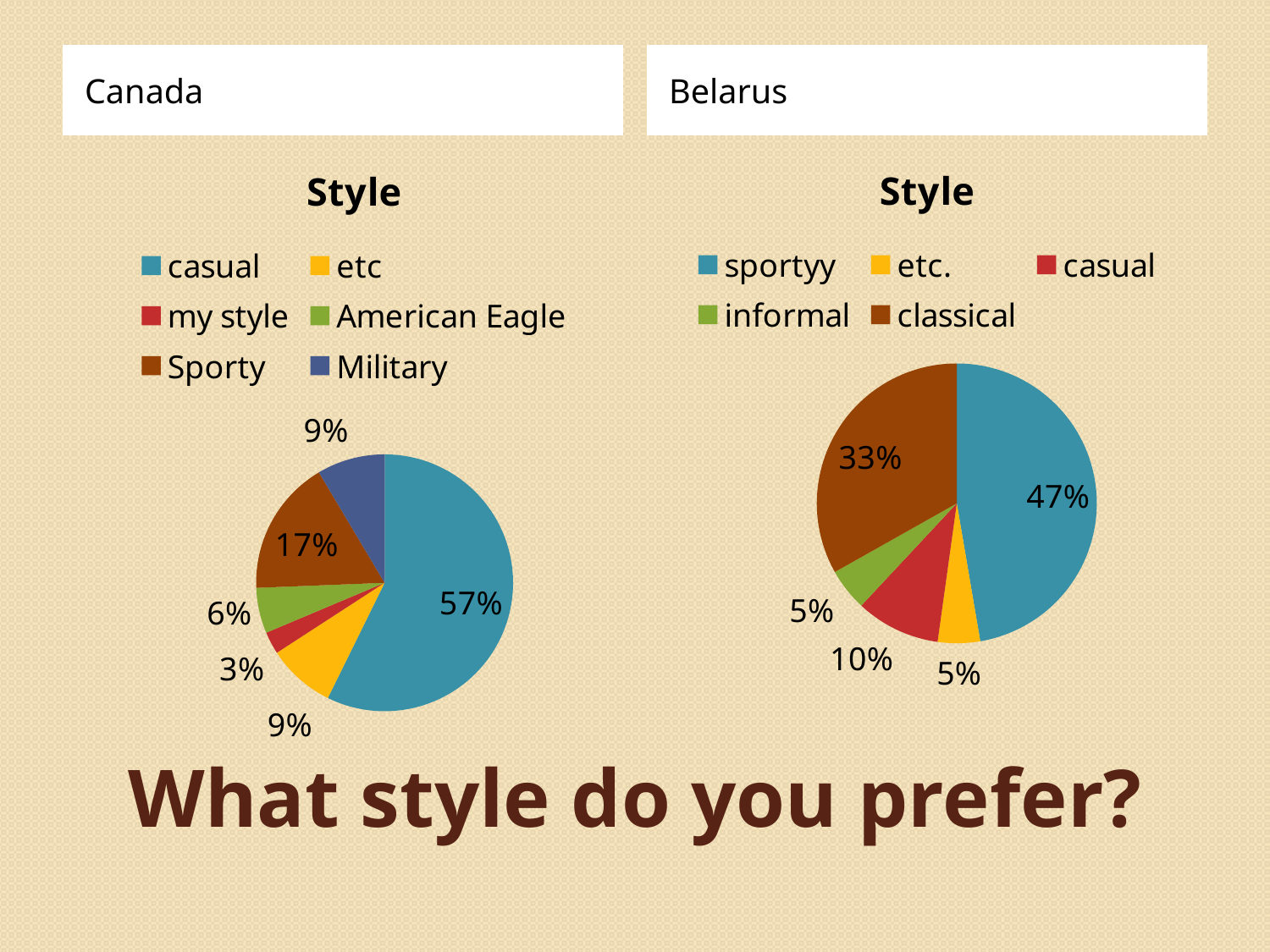
On the right (Belarus) pie chart, what share does classical have? 33% On the left (Canada) pie chart, which category has the largest slice? casual On the right (Belarus) pie chart, what share does sportyy have? 47% On the right (Belarus) pie chart, which is larger, casual or informal? casual On the left (Canada) pie chart, what share does Sporty have? 17% On the left (Canada) pie chart, what share does casual have? 57% What type of chart is used for both Canada and Belarus on this slide? Pie chart On the left (Canada) pie chart, which category has the smallest slice? my style On the left (Canada) pie chart, what share does my style have? 3% On the left (Canada) pie chart, how many categories does the legend list? 6 On the right (Belarus) pie chart, how many categories does the legend list? 5 On the right (Belarus) pie chart, what is the difference between the sportyy and classical shares? 14%